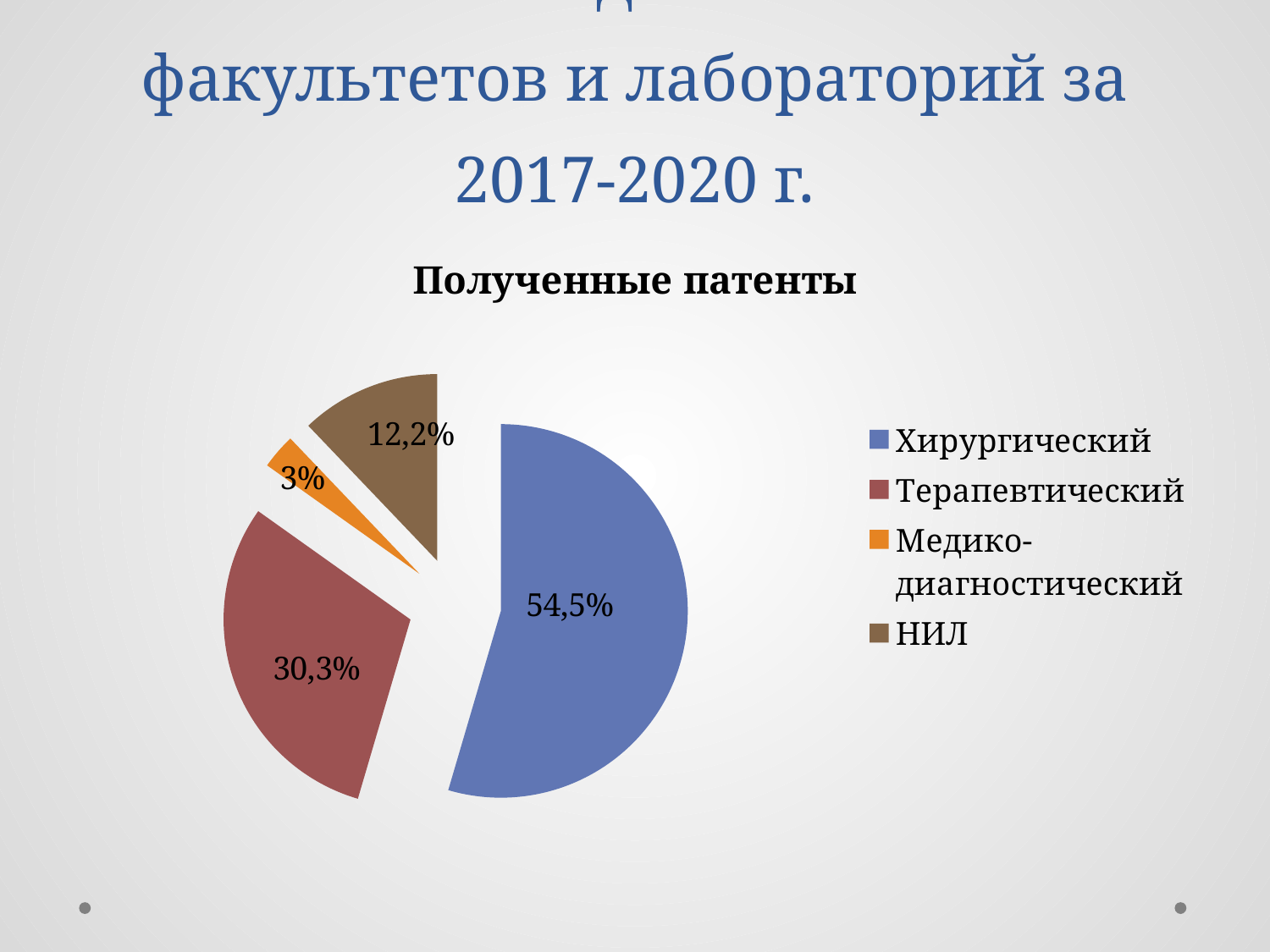
What share of the pie does Терапевтический have? 30,3% What share of the pie does Медико-диагностический have? 3% What is the difference in percentage points between Хирургический and Терапевтический? 24,2 Which category has the smallest slice of the pie? Медико-диагностический Which category has the largest slice of the pie? Хирургический What kind of chart is shown on the slide? Pie chart Which is larger, the share for НИЛ or the share for Медико-диагностический? НИЛ What share of the pie does НИЛ have? 12,2% How many categories are shown in the pie chart? 4 What colour is the slice for Терапевтический? Red What share of the pie does Хирургический have? 54,5% What is the title of the chart? Полученные патенты